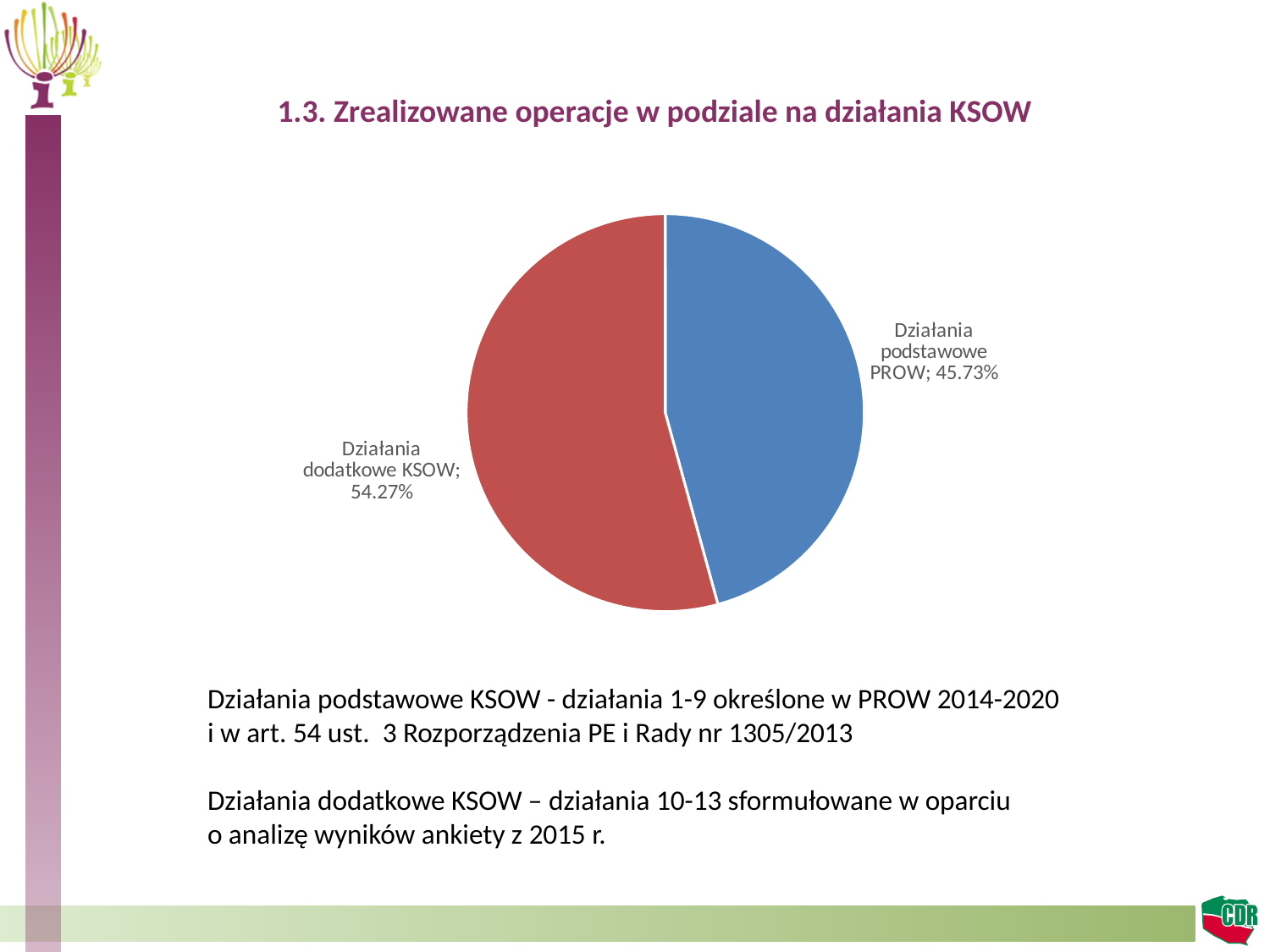
What is the title of the chart on the slide? 1.3. Zrealizowane operacje w podziale na działania KSOW What share of the pie does "Działania dodatkowe KSOW" have? 54.27% What colour is the "Działania podstawowe PROW" slice? blue Which slice of the pie is the smallest? Działania podstawowe PROW What share of the pie does "Działania podstawowe PROW" have? 45.73% How many slices does the pie chart have? 2 What kind of chart is shown on the slide? pie chart Is the share for "Działania podstawowe PROW" greater or less than 50%? less What is the difference in percentage points between the "Działania dodatkowe KSOW" slice and the "Działania podstawowe PROW" slice? 8.54 Which is larger: the share for "Działania dodatkowe KSOW" or the share for "Działania podstawowe PROW"? Działania dodatkowe KSOW Which slice of the pie is the largest? Działania dodatkowe KSOW